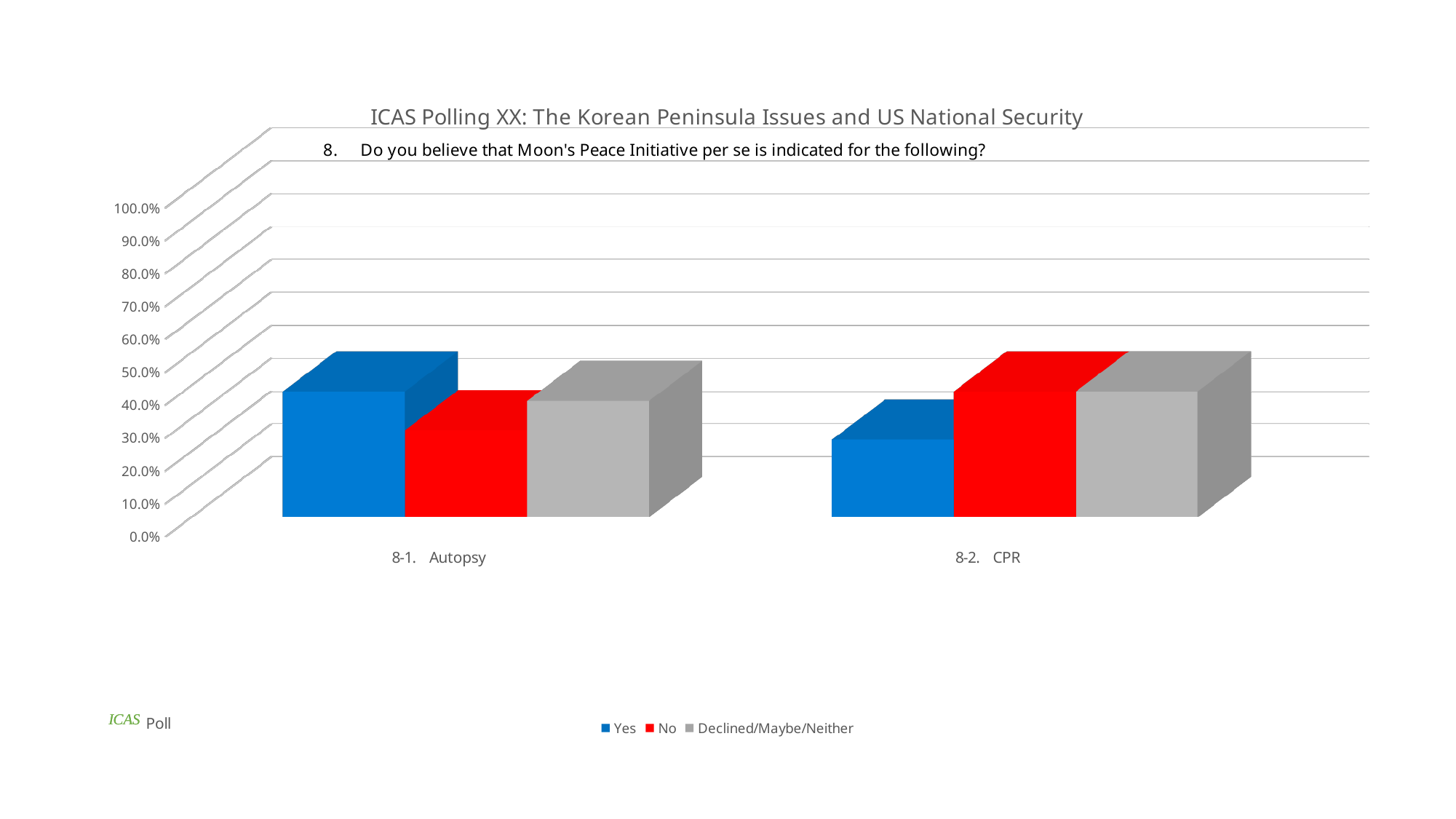
Is the No value for 8-1. Autopsy greater or less than 40.0%? less Is the Yes value for 8-2. CPR greater or less than 30.0%? less For 8-2. CPR, which is larger: the Yes value or the No value? No Which series has the lowest value for 8-2. CPR? Yes What is the title of the chart? ICAS Polling XX: The Korean Peninsula Issues and US National Security Which series has the lowest value for 8-1. Autopsy? No How many series does the chart's legend list? 3 Is the Yes value for 8-1. Autopsy greater or less than 30.0%? greater For 8-1. Autopsy, which is larger: the Yes value or the No value? Yes What kind of chart is shown on the slide? bar chart Which series is shown in red in the chart's legend? No How many categories are shown on the x axis of the chart? 2